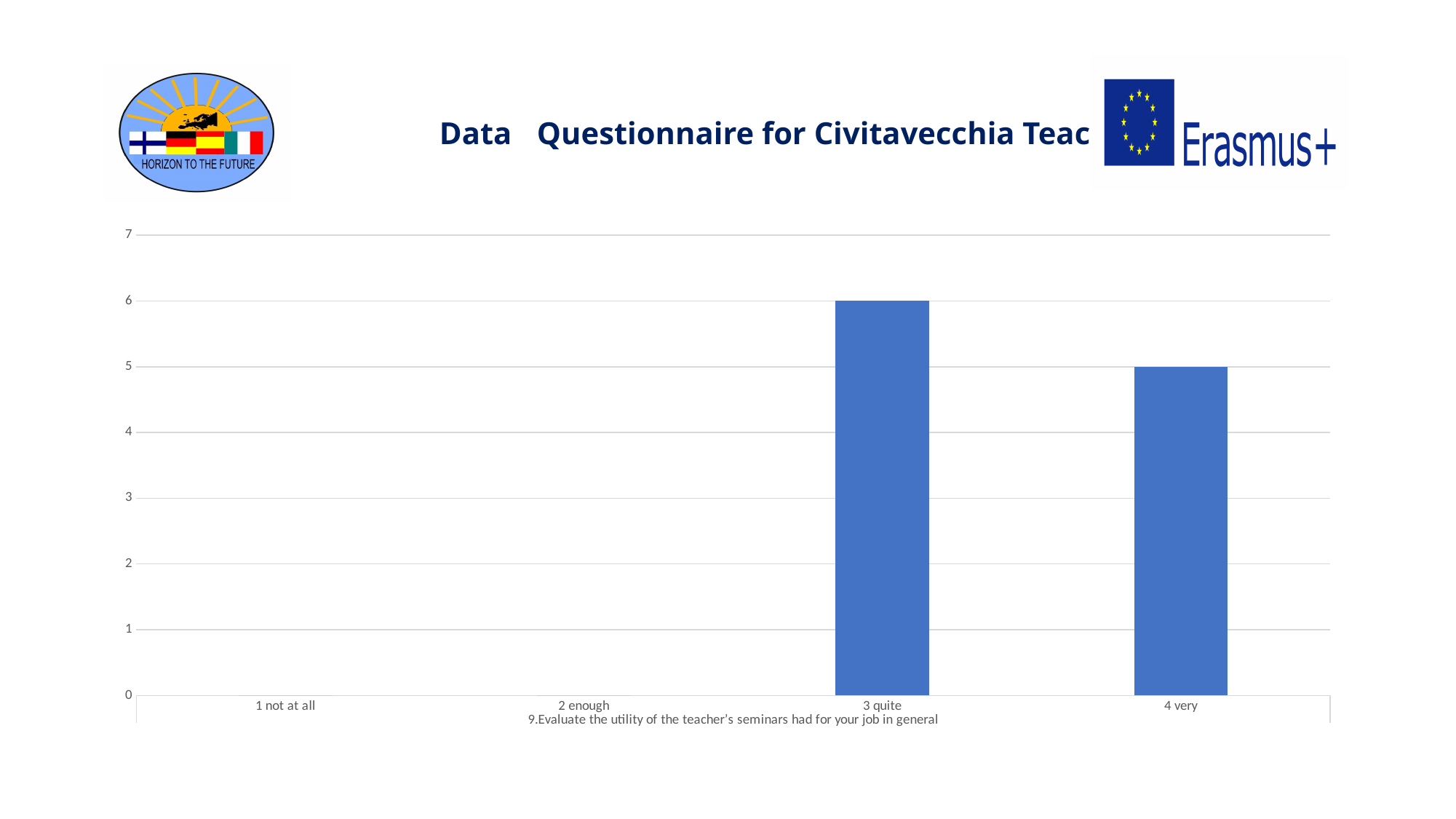
What is the highest value shown on the vertical axis? 7 How many categories are shown on the x axis? 4 Which category has the highest value? 3 quite Which categories have no visible bar? 1 not at all and 2 enough Is the value for "4 very" greater or less than 3? greater What kind of chart is shown on the slide? Bar chart What is the difference between the values for "3 quite" and "4 very"? 1 What is the value for the category "4 very"? 5 What is the value for the category "3 quite"? 6 What is the label shown beneath the x axis of the chart? 9.Evaluate the utility of the teacher's seminars had for your job in general Is the value for "3 quite" greater or less than 7? less Which is larger, the value for "3 quite" or the value for "4 very"? 3 quite